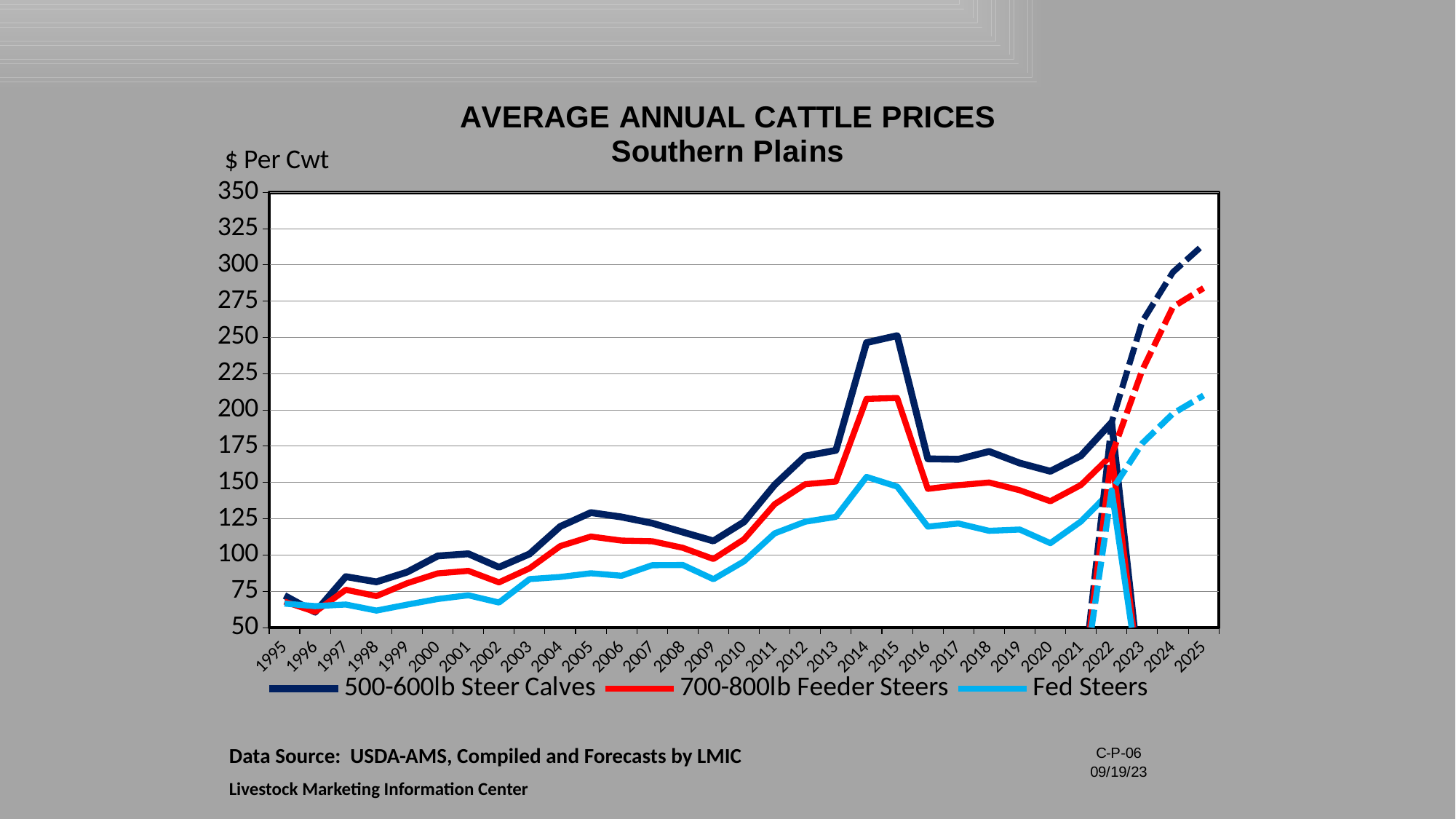
How many years are shown on the x axis? 31 Is the value for 700-800lb Feeder Steers in 2015 greater or less than 200? greater Is the value for 500-600lb Steer Calves in 2015 greater or less than 225? greater What kind of chart is shown on the slide? line chart Is the value for Fed Steers in 2020 greater or less than 125? less Does the 500-600lb Steer Calves series rise or fall from 2015 to 2016? fall In which year does the 500-600lb Steer Calves series reach its highest value? 2025 Which series has the higher value in 2014, 500-600lb Steer Calves or Fed Steers? 500-600lb Steer Calves How many series does the legend list? 3 In which year is the 500-600lb Steer Calves series at its lowest value? 1996